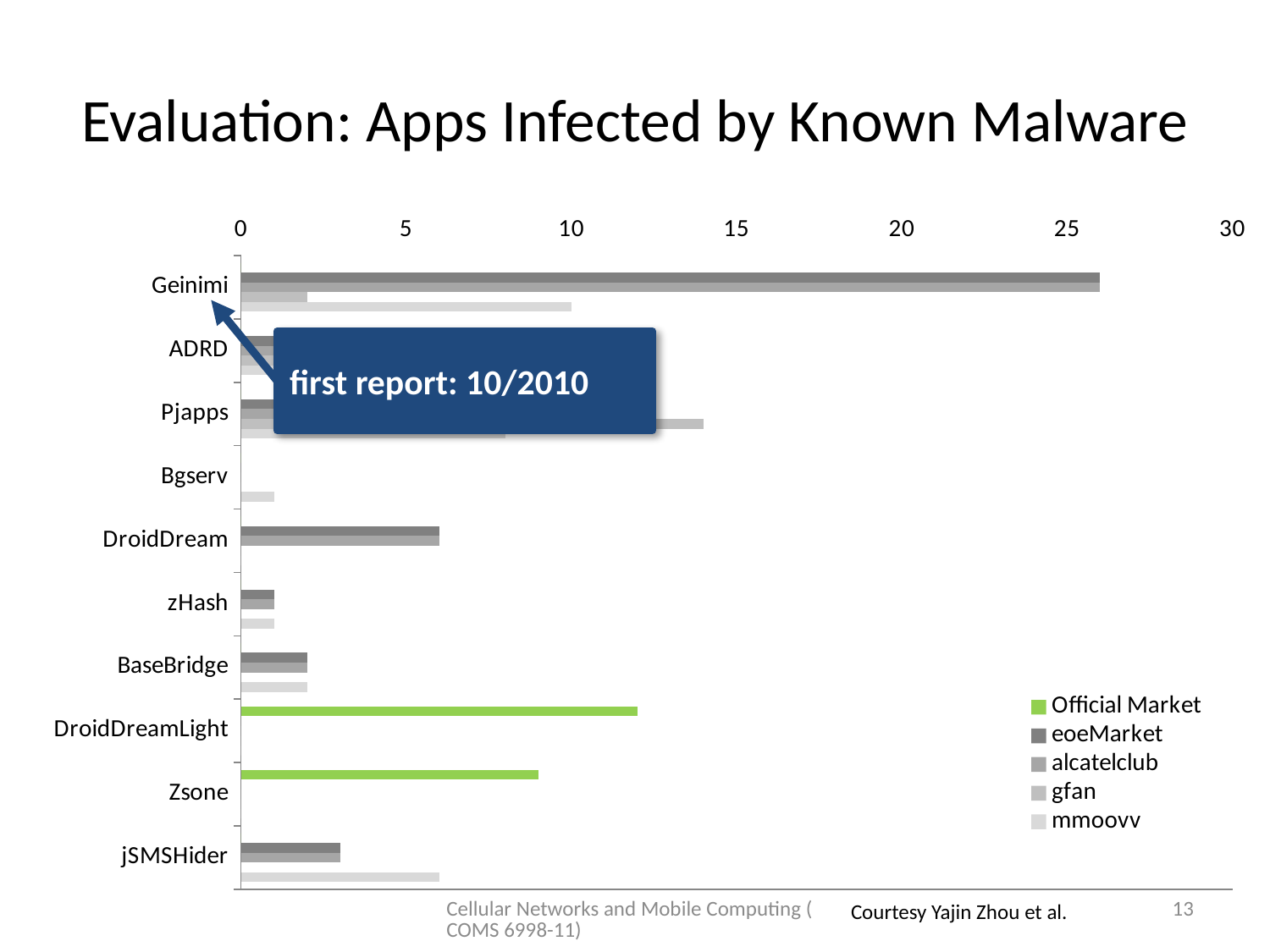
Which has the larger eoeMarket value, DroidDream or jSMSHider? DroidDream Is the eoeMarket value for Geinimi greater or less than 25? greater Which series in the legend is shown in green? Official Market Which has the larger Official Market value, DroidDreamLight or Zsone? DroidDreamLight What text is shown in the blue callout box pointing at Geinimi? first report: 10/2010 Is the gfan value for Pjapps greater or less than 10? greater What kind of chart is shown on the slide? bar chart How many series does the chart's legend list? 5 Which malware family has the longest bar in the chart? Geinimi Is the Official Market value for Zsone greater or less than 10? less How many malware families are listed on the vertical axis of the chart? 10